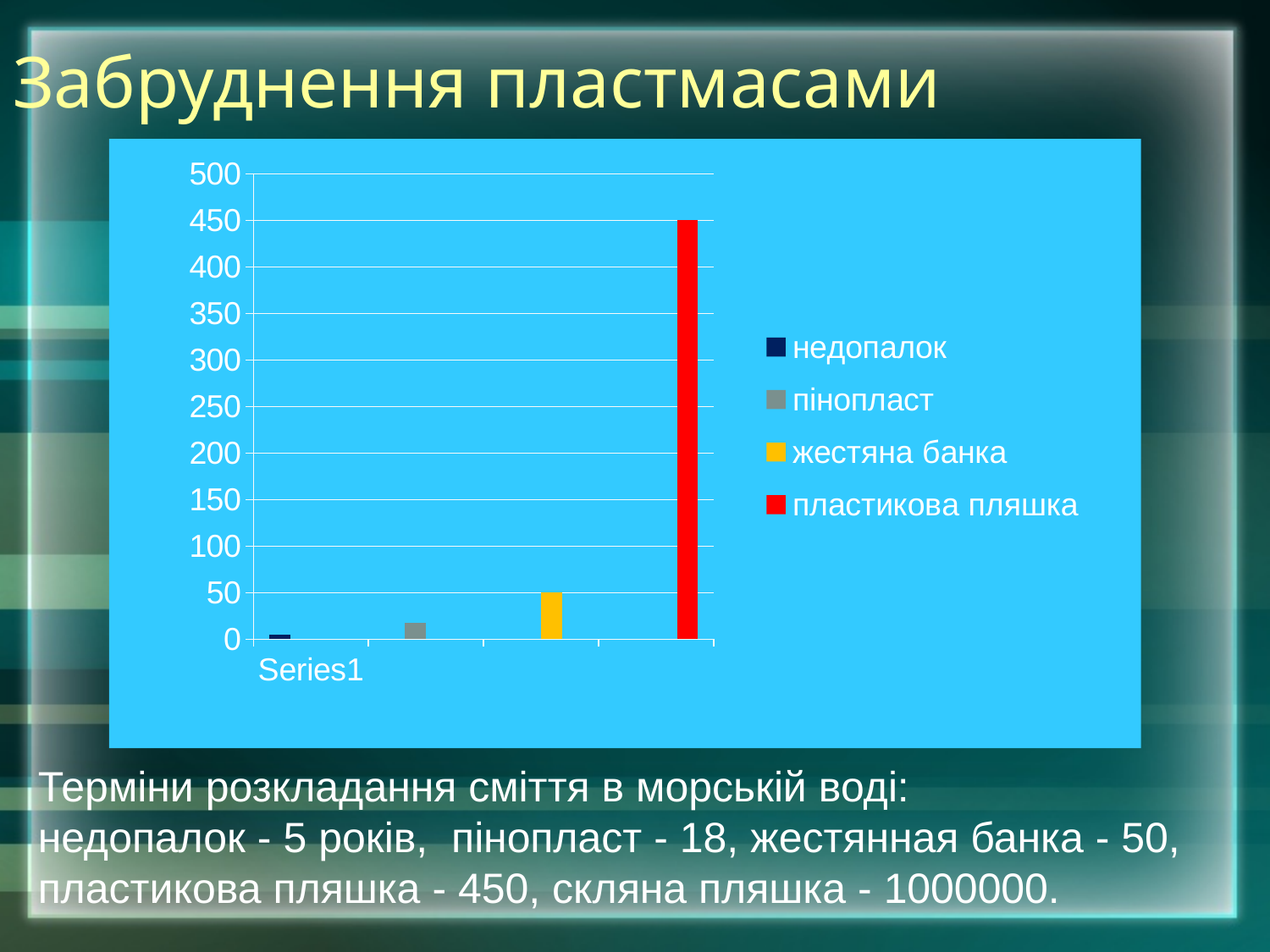
Which series has the lowest bar in the chart? недопалок What is the value of the bar for пластикова пляшка? 450 Which series has the highest bar in the chart? пластикова пляшка What is the value for недопалок according to the slide? 5 What colour is the bar for пластикова пляшка? red What is the value for пінопласт according to the slide? 18 How many series does the chart legend list? 4 What is the value of the bar for жестяна банка? 50 What type of chart is shown on the slide? bar chart What is the difference between the values for пластикова пляшка and жестяна банка? 400 Which is larger, the bar for пінопласт or the bar for жестяна банка? жестяна банка Is the value for пінопласт greater or less than 50? less